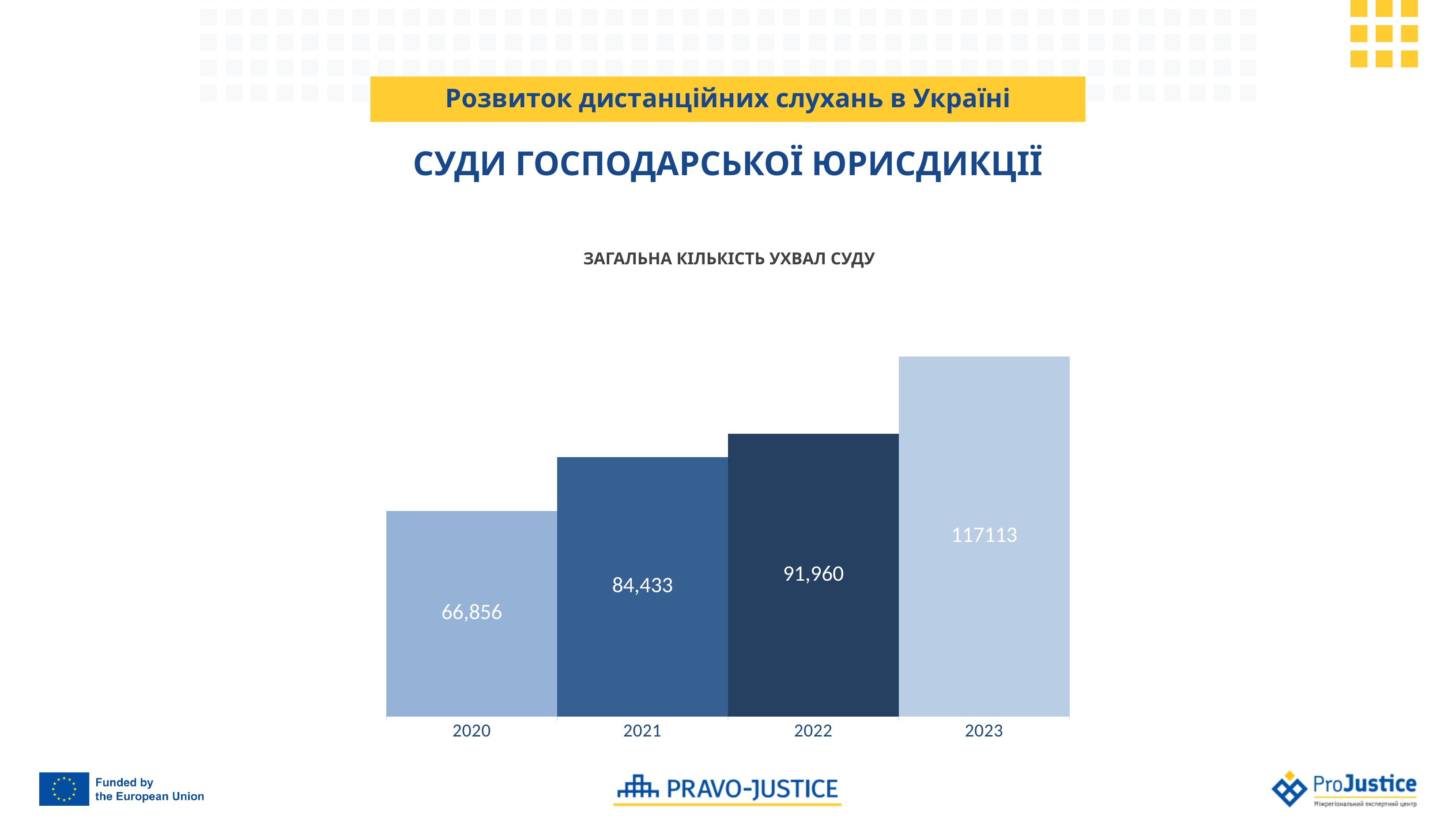
What is the value for 2021 in the chart? 84,433 Which year has the lowest value in the chart? 2020 Which is larger, the value for 2022 or the value for 2021? 2022 What is the value for 2020 in the chart? 66,856 What is the value for 2022 in the chart? 91,960 What is the difference between the values for 2021 and 2020? 17,577 What is the value for 2023 in the chart? 117113 What is the difference between the values for 2023 and 2022? 25,153 Which year has the highest value in the chart? 2023 What kind of chart is shown on the slide? Bar chart How many years are shown in the chart? 4 Do the values rise or fall from 2020 to 2023? Rise